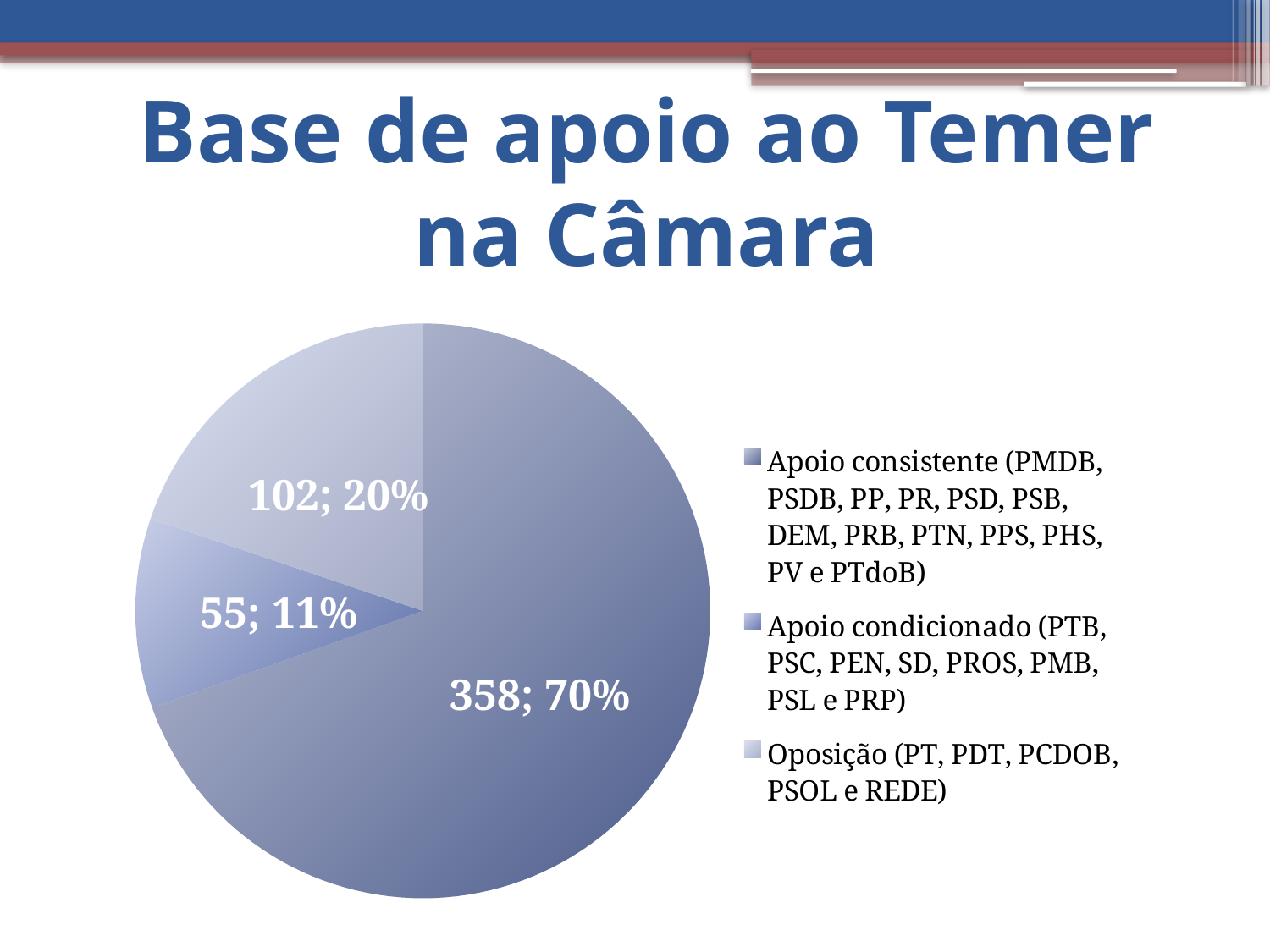
What share of the pie does the 'Oposição' slice represent? 20% What is the title of the slide containing the chart? Base de apoio ao Temer na Câmara What is the value shown for the 'Apoio condicionado' slice? 55 How many slices does the pie chart have? 3 Which category has the largest slice? Apoio consistente What is the value shown for the 'Apoio consistente' slice? 358 What share of the pie does the 'Apoio consistente' slice represent? 70% What is the value shown for the 'Oposição' slice? 102 Which category has the smallest slice? Apoio condicionado How many entries does the legend list? 3 What kind of chart is shown on the slide? pie chart What is the difference between the 'Apoio consistente' value and the 'Oposição' value? 256